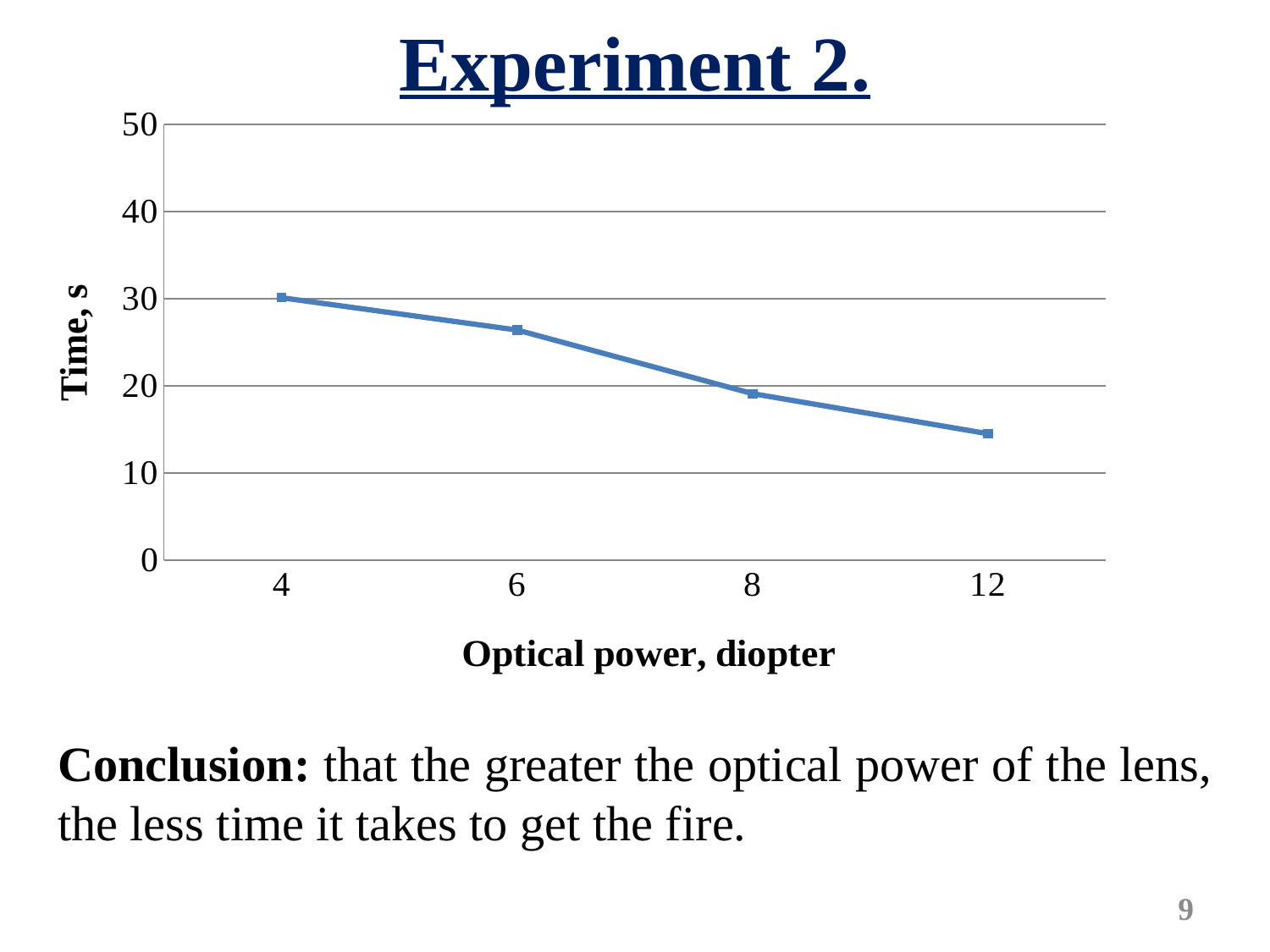
Which has a larger time value: optical power 6 or optical power 12? 6 How many data points are plotted on the line? 4 What is the label of the x axis? Optical power, diopter What is the label of the y axis? Time, s Does the time rise or fall as optical power increases along the x axis? fall Is the time for an optical power of 12 diopters greater or less than 10? greater At which optical power is the time lowest? 12 What kind of chart is shown on the slide? line chart At which optical power is the time highest? 4 Is the time for an optical power of 6 diopters greater or less than 30? less Is the time for an optical power of 6 diopters greater or less than 20? greater